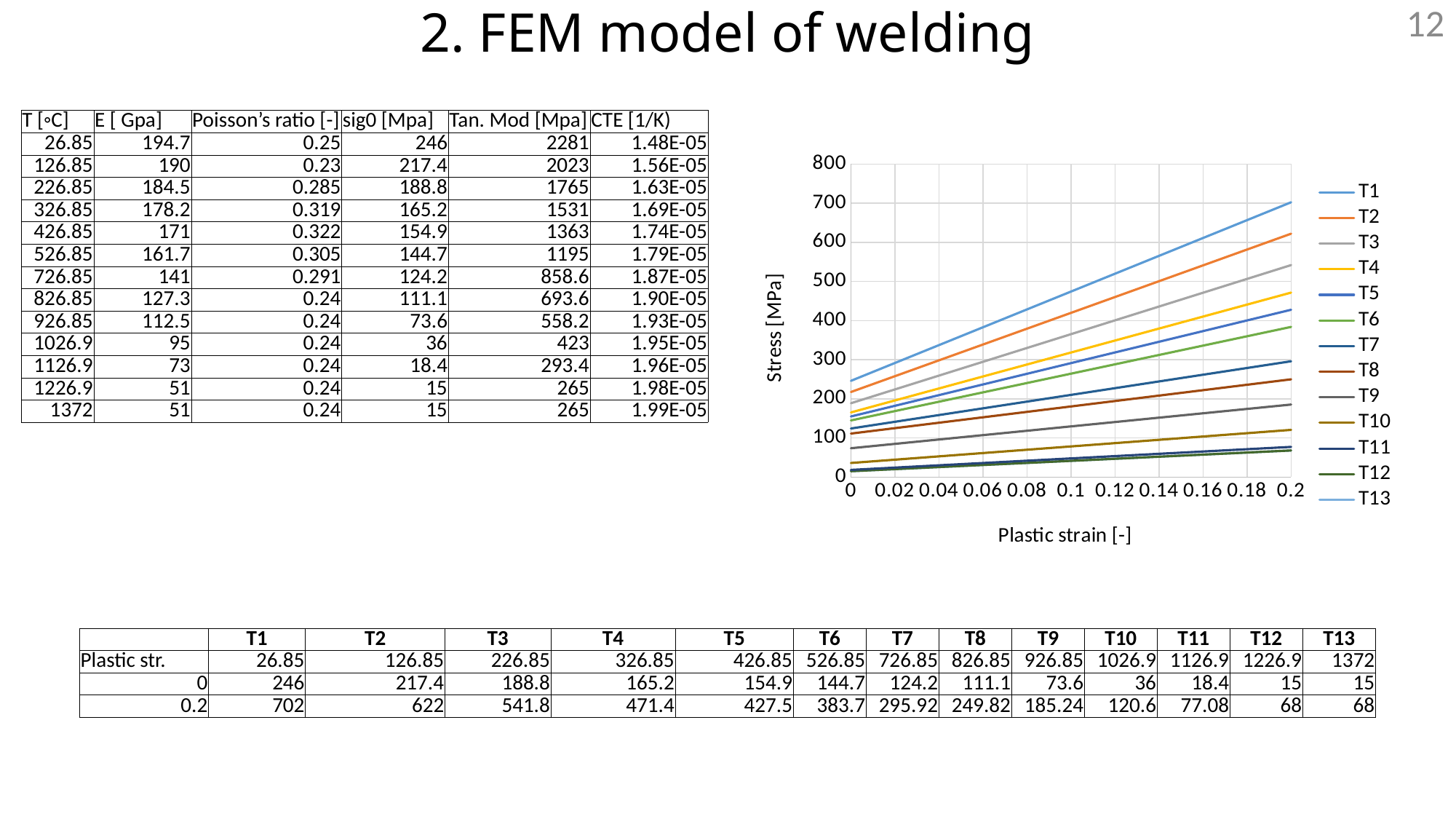
Is the stress for T9 at a plastic strain of 0.2 greater or less than 200? less Which series has the highest stress at a plastic strain of 0.2? T1 What is the difference between the stress of T1 and T2 at a plastic strain of 0.2? 80 At a plastic strain of 0.2, which series has the larger stress, T3 or T4? T3 What is the stress for series T5 at a plastic strain of 0? 154.9 What kind of chart is shown on the slide? line chart What is the label of the chart's horizontal axis? Plastic strain [-] Do the stress values rise or fall as plastic strain increases along the x axis? rise What is the label of the chart's vertical axis? Stress [MPa] How many series does the chart legend list? 13 Is the stress for T1 at a plastic strain of 0.2 greater or less than 600? greater What is the stress for series T1 at a plastic strain of 0.2? 702